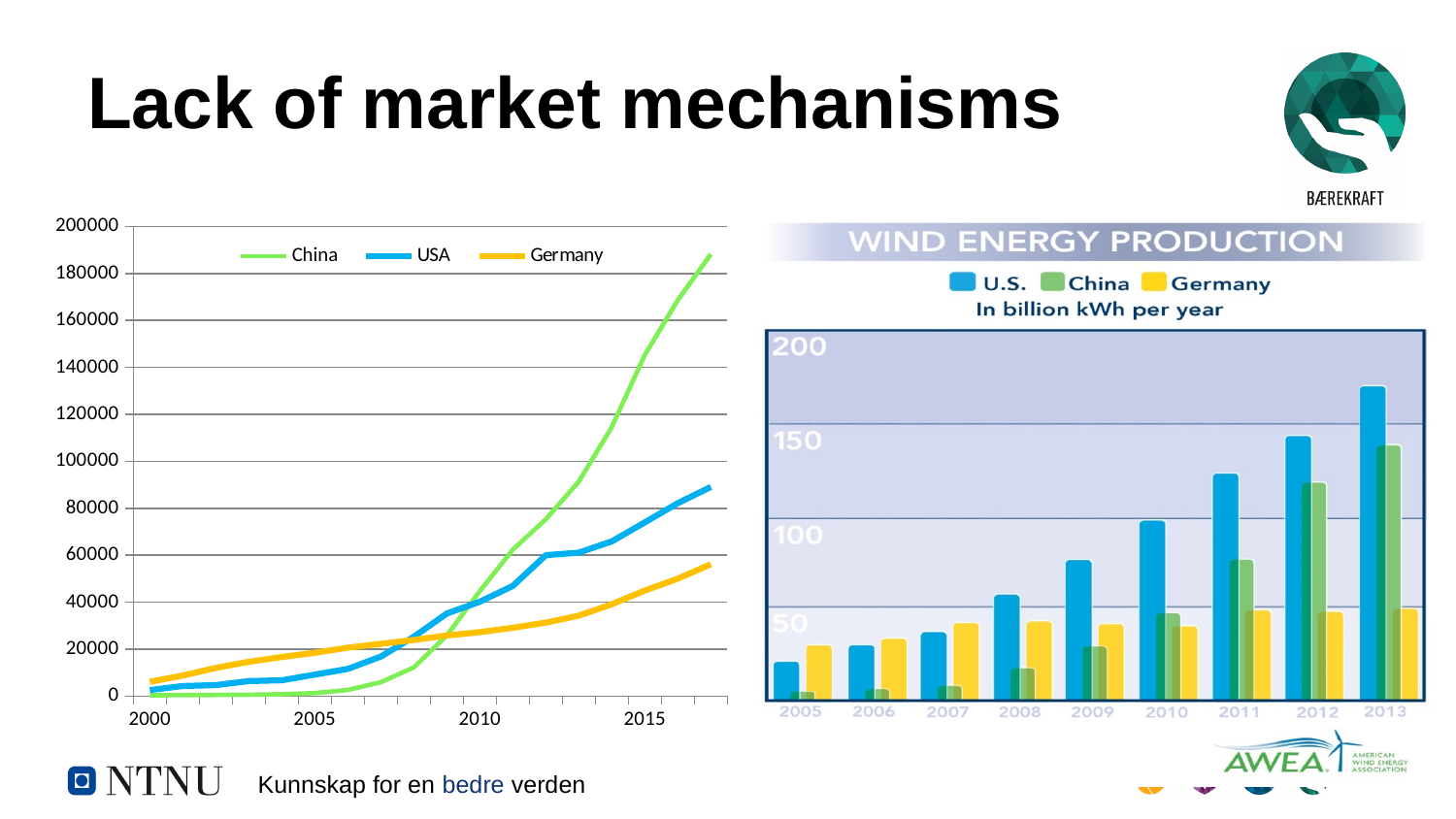
In the 'WIND ENERGY PRODUCTION' chart, which year has the highest U.S. bar? 2013 In the left chart, is the value for USA in 2017 greater or less than 80000? greater In the left chart, which series is larger in 2015, USA or Germany? USA How many years are shown on the x axis of the 'WIND ENERGY PRODUCTION' chart? 9 In the left chart, which series has the highest value in 2017? China How many series does the legend of the left chart list? 3 In what unit are the values of the 'WIND ENERGY PRODUCTION' chart given? billion kWh per year In the 'WIND ENERGY PRODUCTION' chart, which is larger in 2005, U.S. or Germany? Germany In the left chart, is the value for China in 2017 greater or less than 180000? greater What kind of chart is the 'WIND ENERGY PRODUCTION' chart on the right? bar chart In the 'WIND ENERGY PRODUCTION' chart, is the U.S. value for 2013 greater or less than 150? greater What kind of chart is the chart on the left of the slide? line chart